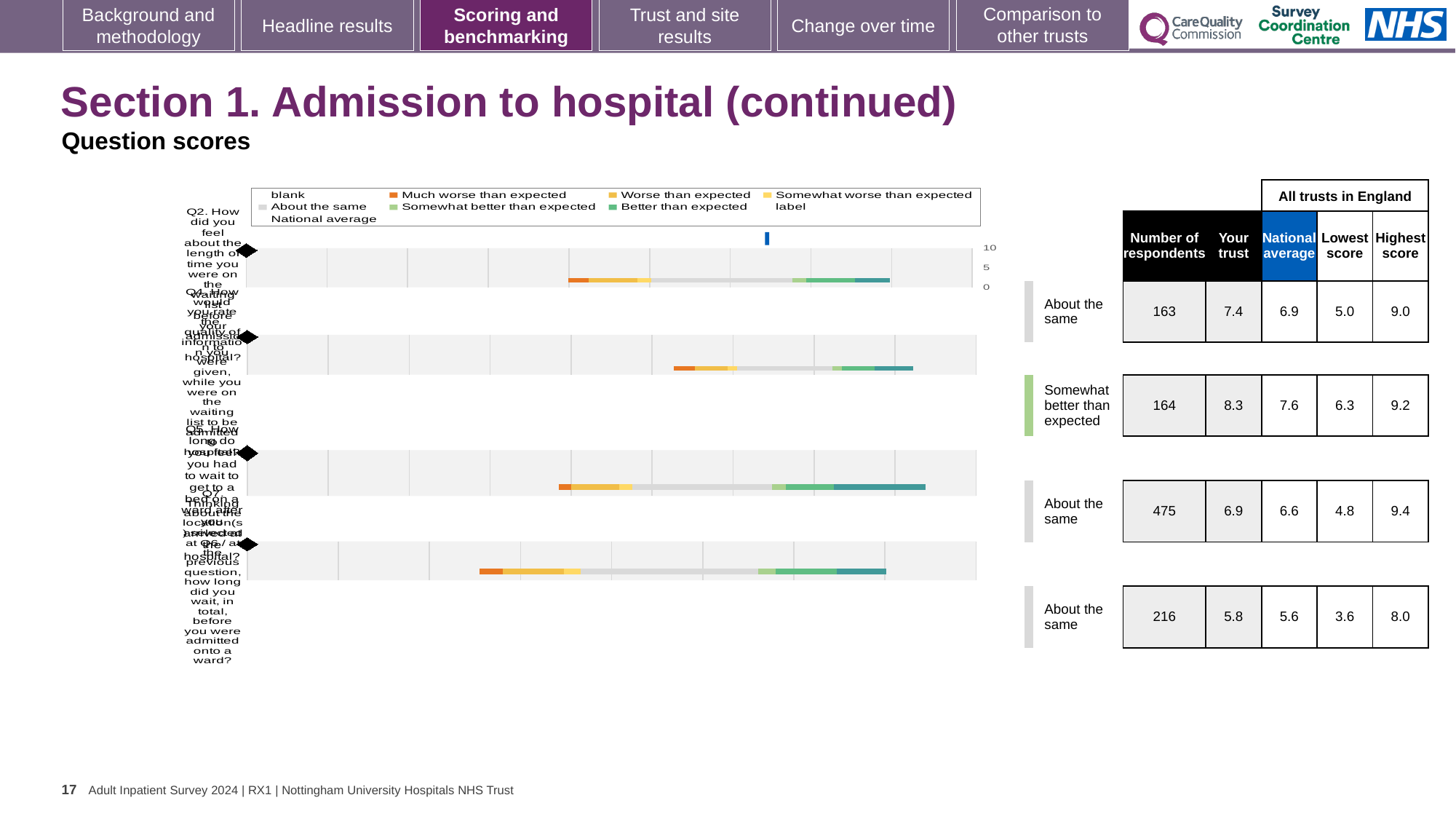
Which legend entry is shown in orange on the chart? Much worse than expected In the table beside the chart, what is the national average for the third row? 6.6 In the table beside the chart, what is the lowest score for the fourth row? 3.6 What is the highest value shown on the chart's axis? 10 In the table beside the chart, what is the difference between the 'Your trust' score and the national average in the first row? 0.5 In the table beside the chart, which row has the highest number of respondents? the third row (475) In the table beside the chart, which row has the lowest 'Your trust' score? the fourth row (5.8) How many question rows (bars) does the chart show? 4 In the table beside the chart, what is the 'Your trust' score for the second row? 8.3 Which benchmark category is shown for the second row of the chart? Somewhat better than expected In the table beside the chart, what is the number of respondents for the first row? 163 What kind of chart is shown on the slide? bar chart